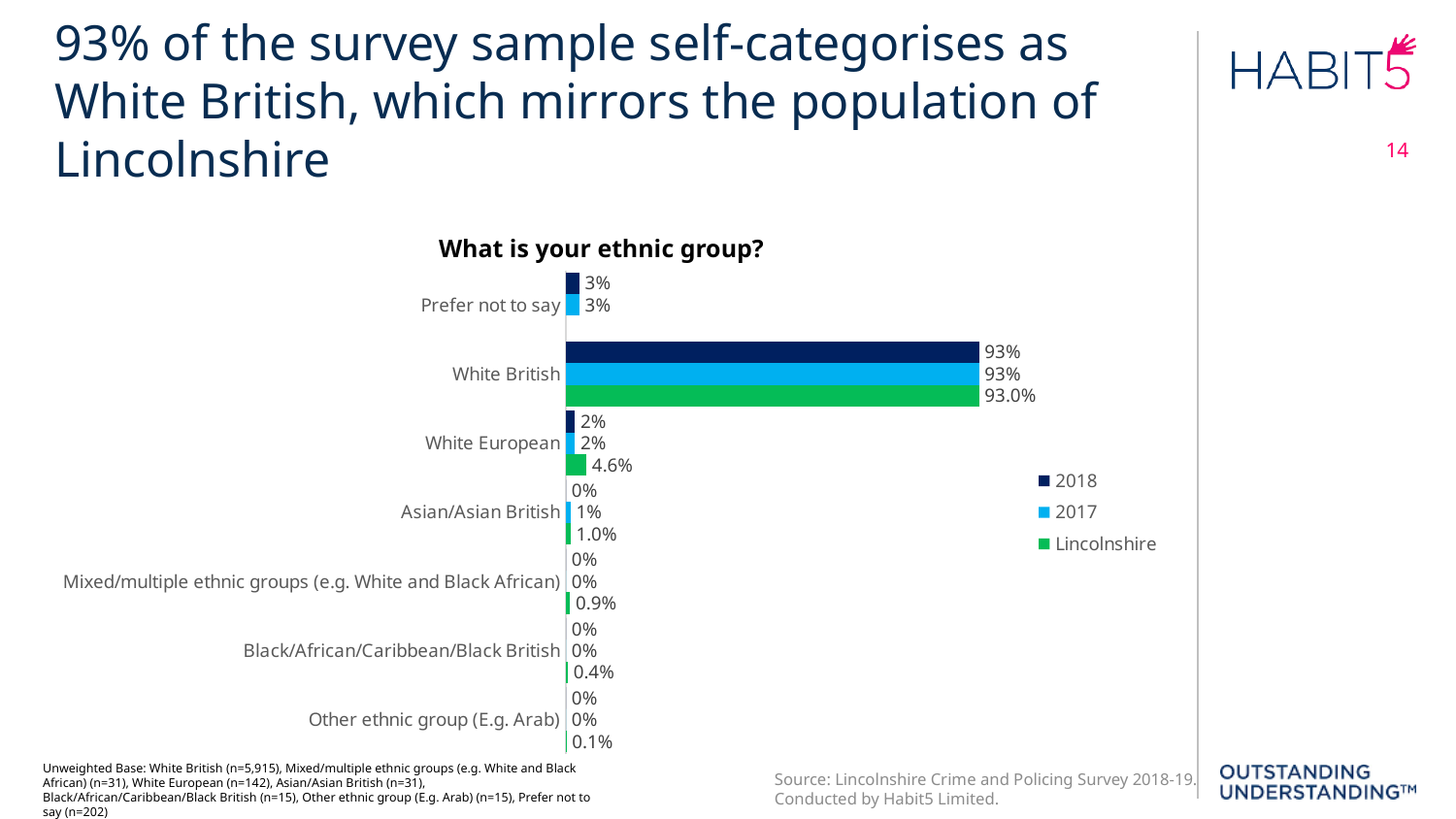
What is the Lincolnshire value for Black/African/Caribbean/Black British? 0.4% What is the 2017 value for Asian/Asian British? 1% What is the Lincolnshire value for White European? 4.6% What is the 2018 value for White British? 93% How many ethnic group categories are shown on the chart? 7 What is the difference between the Lincolnshire value and the 2018 value for White European? 2.6% How many series does the legend list? 3 What is the 2018 value for Prefer not to say? 3% Which ethnic group has the highest value in the 2018 series? White British What type of chart is shown on the slide? Bar chart Which is larger for Mixed/multiple ethnic groups: the Lincolnshire value or the 2018 value? Lincolnshire Which ethnic group has the lowest Lincolnshire value? Other ethnic group (E.g. Arab)